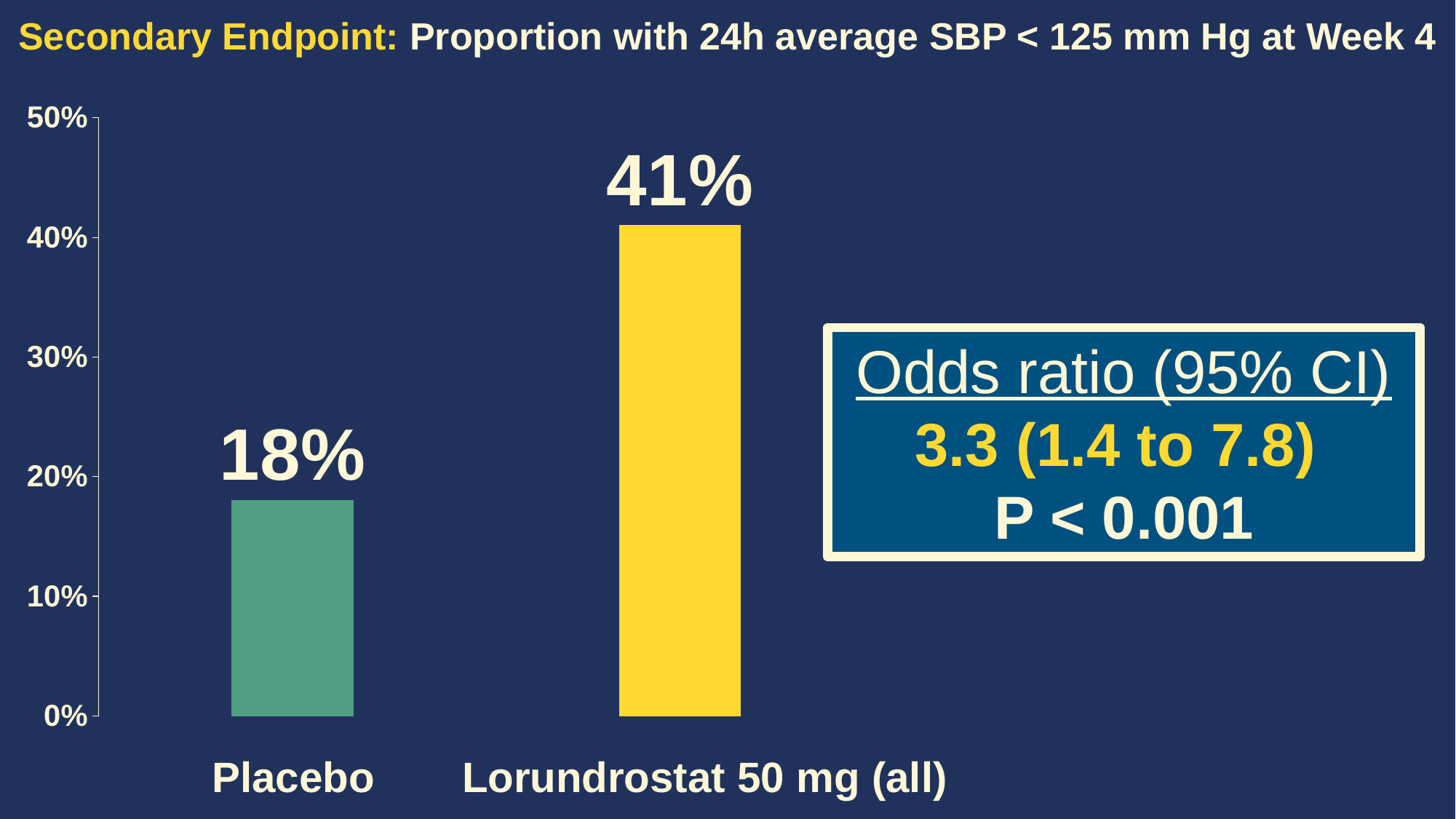
What proportion of the Placebo group had a 24h average SBP < 125 mm Hg at Week 4? 18% Is the Placebo bar larger or smaller than the Lorundrostat 50 mg (all) bar? smaller Is the value for Lorundrostat 50 mg (all) greater or less than 40%? greater What is the difference in percentage points between the Lorundrostat 50 mg (all) and Placebo bars? 23 percentage points Is the value for Placebo greater or less than 20%? less What is the maximum value shown on the y-axis? 50% How many groups are shown as bars in the chart? 2 What type of chart is shown on the slide? Bar chart Which group has the lower proportion with 24h average SBP < 125 mm Hg? Placebo What proportion of the Lorundrostat 50 mg (all) group had a 24h average SBP < 125 mm Hg at Week 4? 41% What odds ratio is reported in the box on the slide? 3.3 (1.4 to 7.8) Which group has the higher proportion with 24h average SBP < 125 mm Hg? Lorundrostat 50 mg (all)